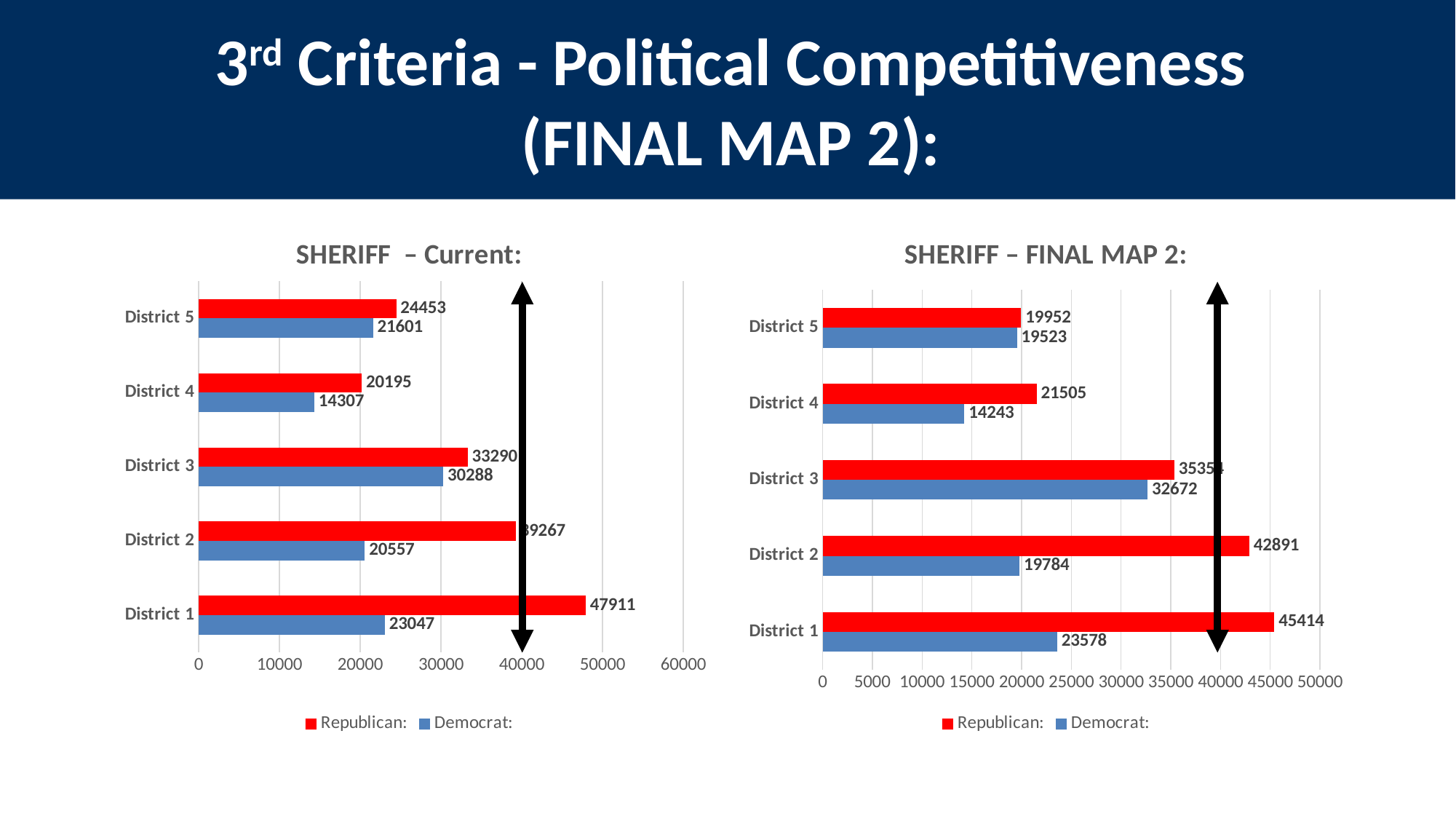
In the SHERIFF – FINAL MAP 2 chart, what is the difference between the Republican and Democrat values for District 1? 21836 In the SHERIFF – Current chart, is the Republican value for District 2 greater or less than 30000? greater How many districts are shown in the SHERIFF – FINAL MAP 2 chart? 5 In the SHERIFF – Current chart, which district has the highest Republican value? District 1 In the SHERIFF – Current chart, what is the difference between the Republican and Democrat values for District 5? 2852 In the SHERIFF – FINAL MAP 2 chart, is the Democrat value for District 3 larger than the Democrat value for District 2? Yes In the SHERIFF – Current chart, what is the Democrat value for District 4? 14307 In the SHERIFF – FINAL MAP 2 chart, what is the Democrat value for District 5? 19523 In the SHERIFF – FINAL MAP 2 chart, what is the Republican value for District 2? 42891 In the SHERIFF – Current chart, what is the Republican value for District 1? 47911 In the SHERIFF – FINAL MAP 2 chart, which district has the lowest Democrat value? District 4 What type of chart is the SHERIFF – Current chart? Bar chart